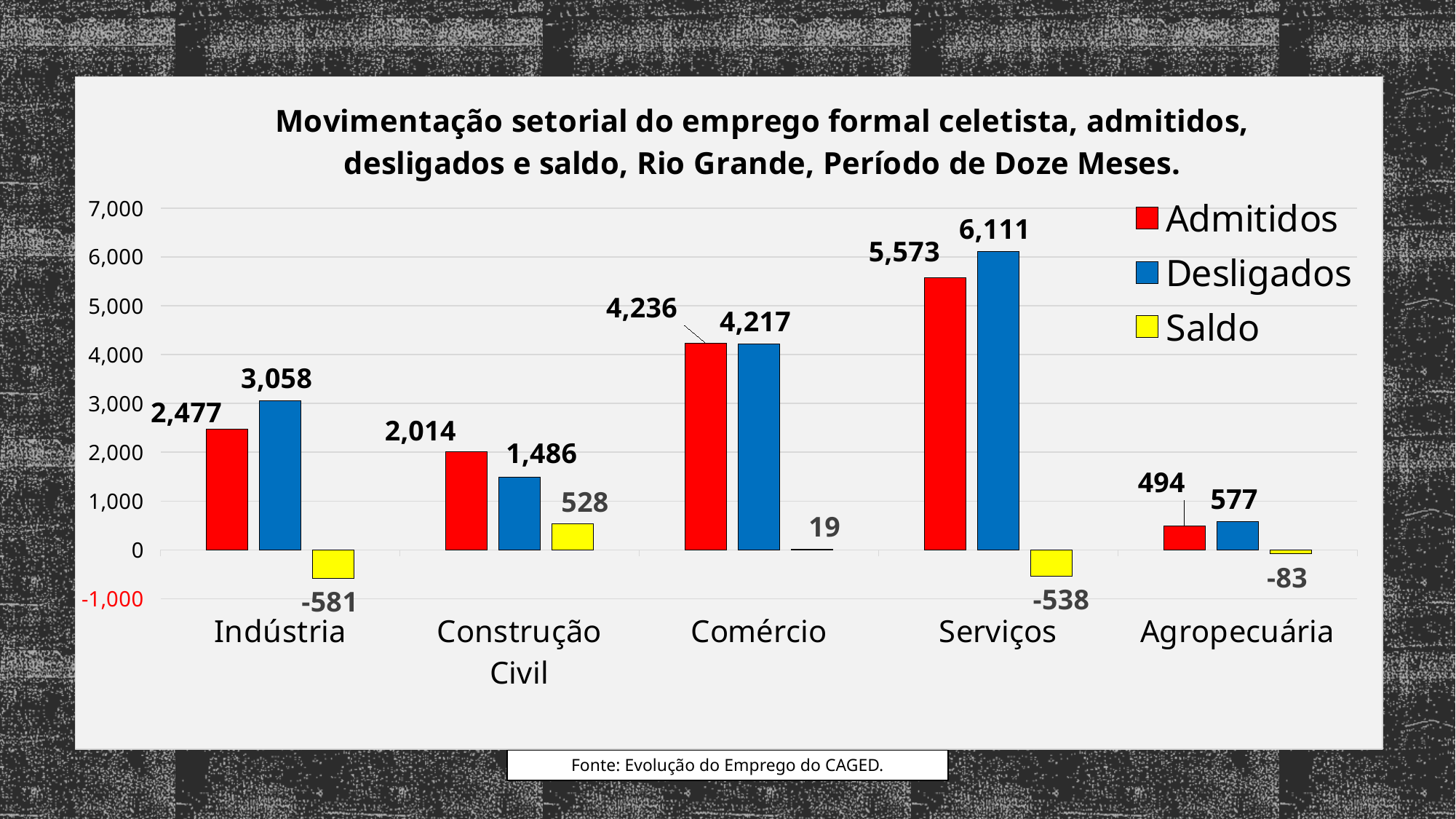
What is the Saldo value for Agropecuária? -83 What kind of chart is shown on the slide? Bar chart Which is larger for Construção Civil, Admitidos or Desligados? Admitidos What colour represents the Saldo series? Yellow How many series does the legend list? 3 What is the difference between Desligados and Admitidos for Indústria? 581 Which sector has the lowest Desligados value? Agropecuária What is the Desligados value for Serviços? 6,111 How many sectors are shown on the x axis? 5 Which sector has the highest Admitidos value? Serviços What is the Saldo value for Indústria? -581 What is the Admitidos value for Comércio? 4,236